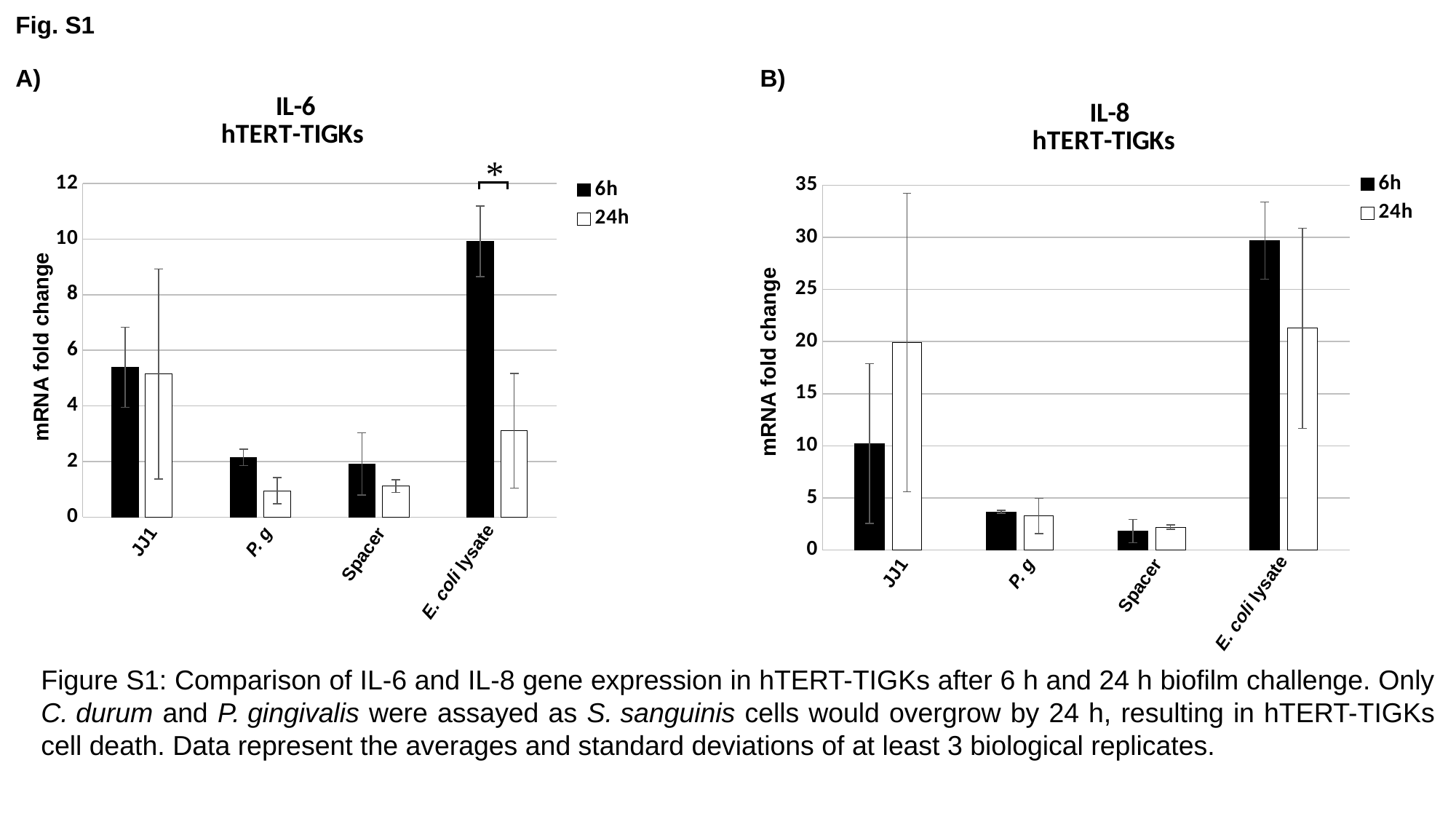
In the IL-6 hTERT-TIGKs chart, what kind of chart is shown? bar chart In the IL-8 hTERT-TIGKs chart, what is the y-axis title? mRNA fold change In the IL-6 hTERT-TIGKs chart, which category has the highest 6h value? E. coli lysate In the IL-8 hTERT-TIGKs chart, which category has the highest 6h value? E. coli lysate In the IL-8 hTERT-TIGKs chart, is the 6h value for E. coli lysate greater or less than 25? greater In the IL-6 hTERT-TIGKs chart, is the 6h value for E. coli lysate greater or less than 8? greater In the IL-8 hTERT-TIGKs chart, which category has the lowest 6h value? Spacer In the IL-6 hTERT-TIGKs chart, which is larger: the 6h value for JJ1 or the 6h value for E. coli lysate? E. coli lysate In the IL-8 hTERT-TIGKs chart, which is larger for JJ1: the 6h value or the 24h value? 24h In the IL-8 hTERT-TIGKs chart, is the 24h value for JJ1 greater or less than 15? greater In the IL-6 hTERT-TIGKs chart, how many series does the legend list? 2 In the IL-6 hTERT-TIGKs chart, how many categories are shown on the x axis? 4